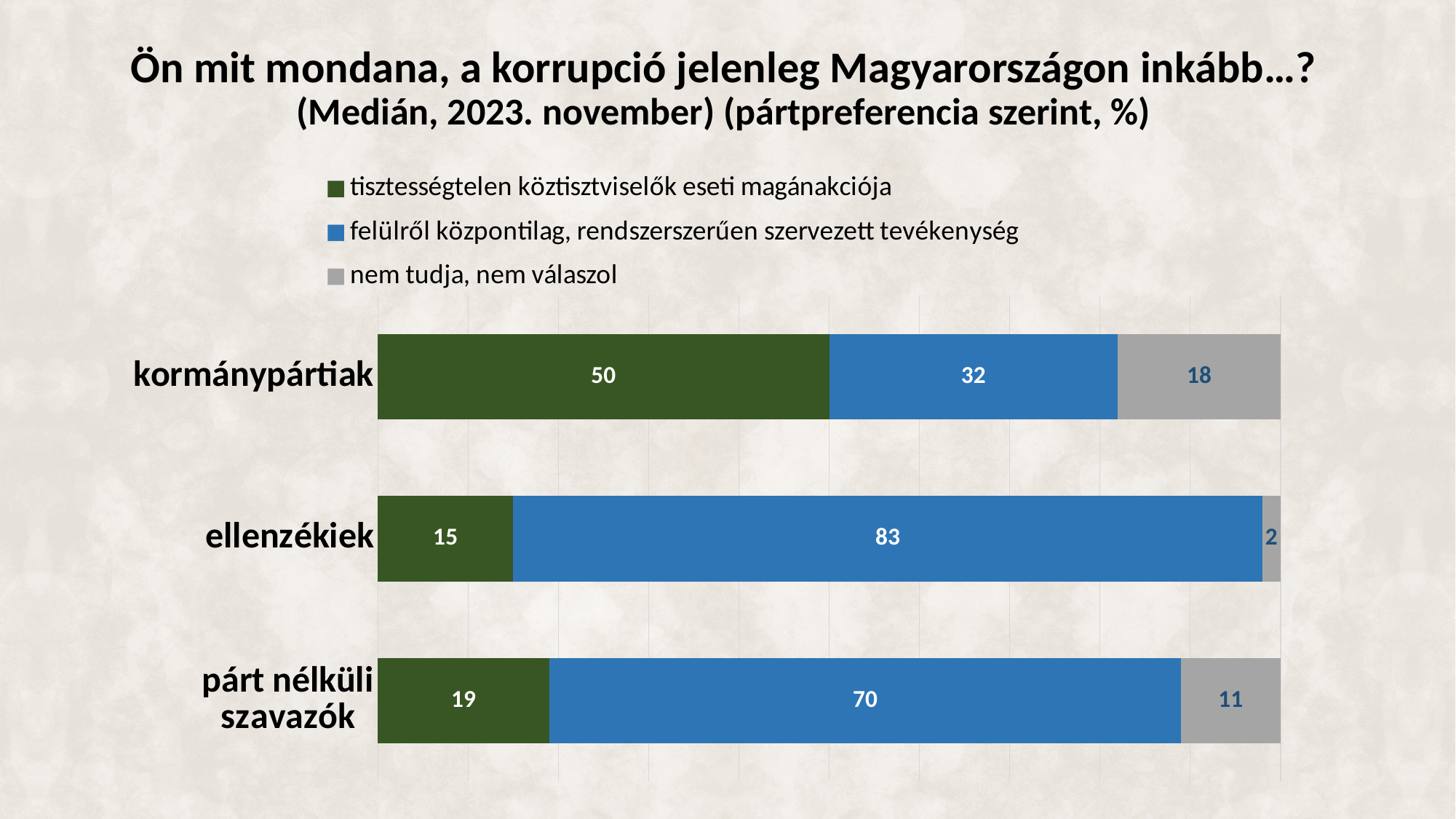
Which is larger: the 'tisztességtelen köztisztviselők eseti magánakciója' value for párt nélküli szavazók or for ellenzékiek? párt nélküli szavazók What is the value for 'felülről központilag, rendszerszerűen szervezett tevékenység' among ellenzékiek? 83 Which colour represents 'nem tudja, nem válaszol' in the legend? grey What is the difference between the 'felülről központilag, rendszerszerűen szervezett tevékenység' values for ellenzékiek and kormánypártiak? 51 What is the value for 'tisztességtelen köztisztviselők eseti magánakciója' among kormánypártiak? 50 What is the value for 'nem tudja, nem válaszol' among párt nélküli szavazók? 11 How many series does the legend list? 3 What is the total of the stacked bar for kormánypártiak? 100 Which group has the lowest value for 'nem tudja, nem válaszol'? ellenzékiek What kind of chart is shown on the slide? stacked bar chart How many groups (categories) are shown on the chart? 3 Which group has the highest value for 'felülről központilag, rendszerszerűen szervezett tevékenység'? ellenzékiek